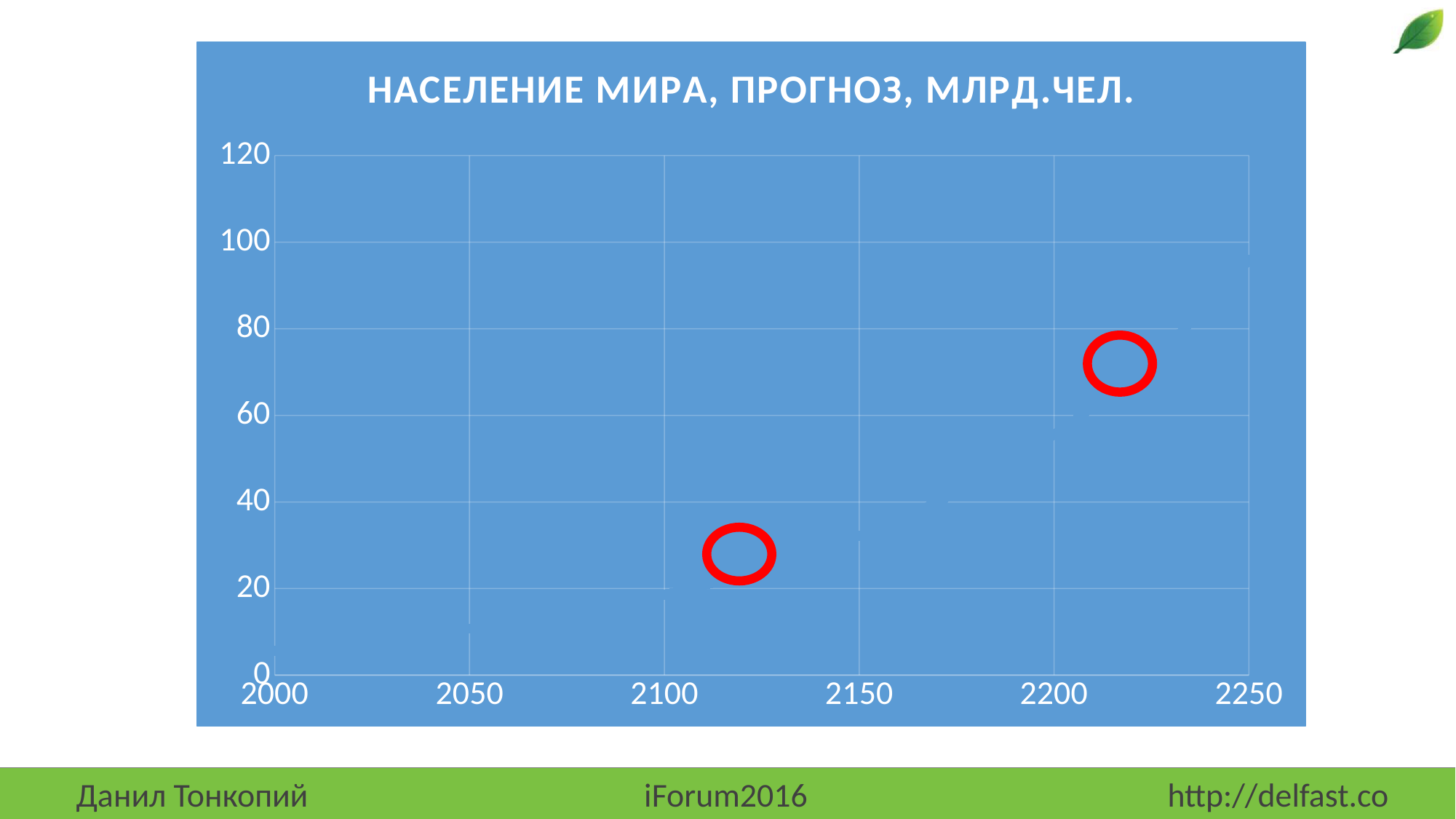
Is the value of the red-circled point near the year 2215 greater or less than 100? less Is the value of the red-circled point near the year 2120 greater or less than 40? less How many red circles highlight points on the chart? 2 Is the value of the red-circled point near the year 2120 greater or less than 20? greater What is the title of the chart? НАСЕЛЕНИЕ МИРА, ПРОГНОЗ, МЛРД.ЧЕЛ. Do the highlighted values rise or fall as the year increases along the x axis? rise What is the highest value shown on the vertical axis? 120 Which red-circled point has the larger value: the one near 2120 or the one near 2215? the one near 2215